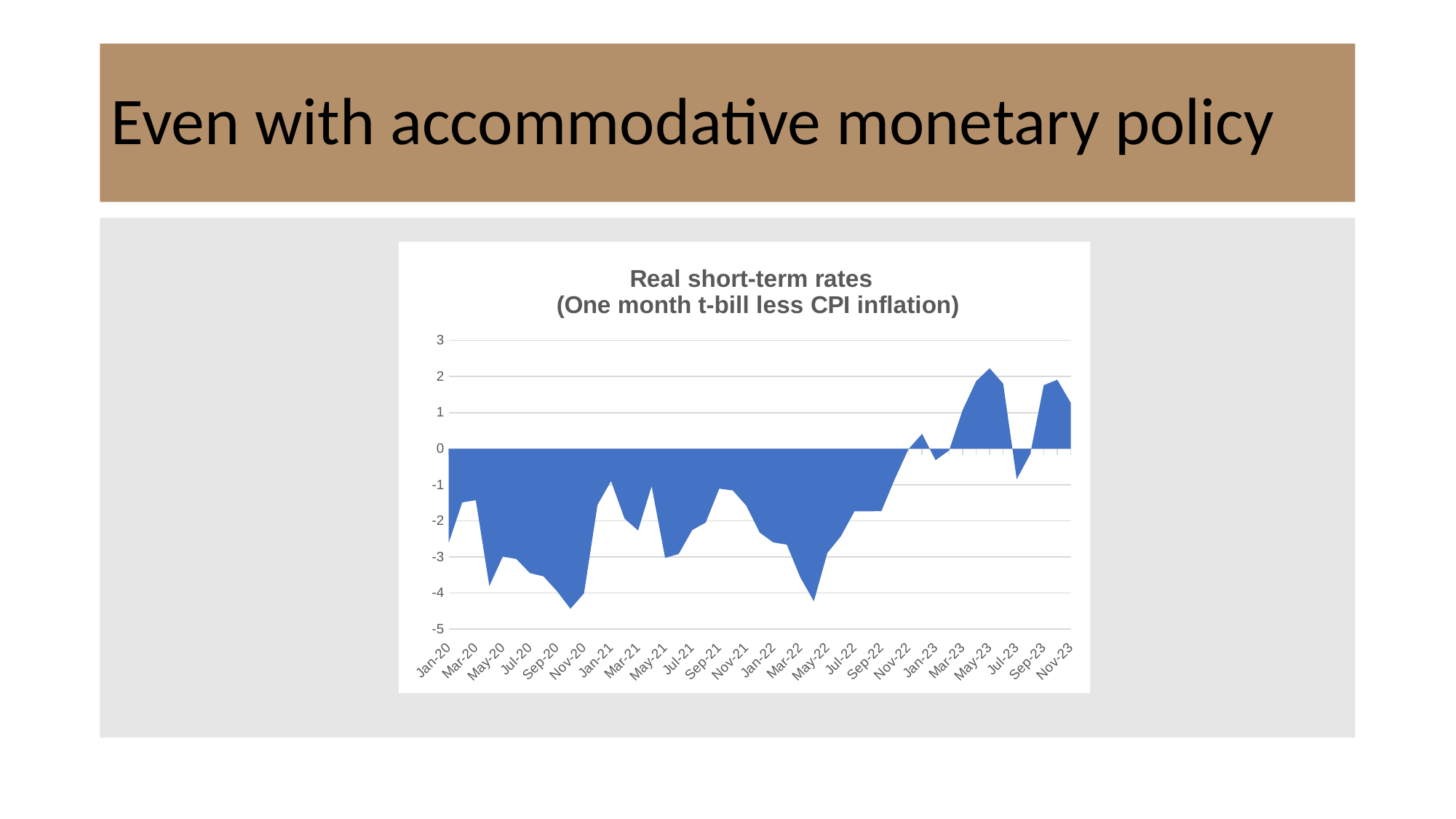
Is the value for Jul-23 greater or less than 0? less What is the title of the chart? Real short-term rates (One month t-bill less CPI inflation) Is the value for Sep-22 greater or less than -1? less Which is higher, the value for May-23 or the value for Jul-23? May-23 What are the lowest and highest values shown on the vertical axis of the chart? -5 and 3 Which is lower, the value for Nov-20 or the value for Jan-21? Nov-20 Is the value for May-23 greater or less than 1? greater What kind of chart is shown on the slide? Area chart Do the values generally rise or fall between Jul-22 and May-23? rise How many month labels are shown along the x axis of the chart? 24